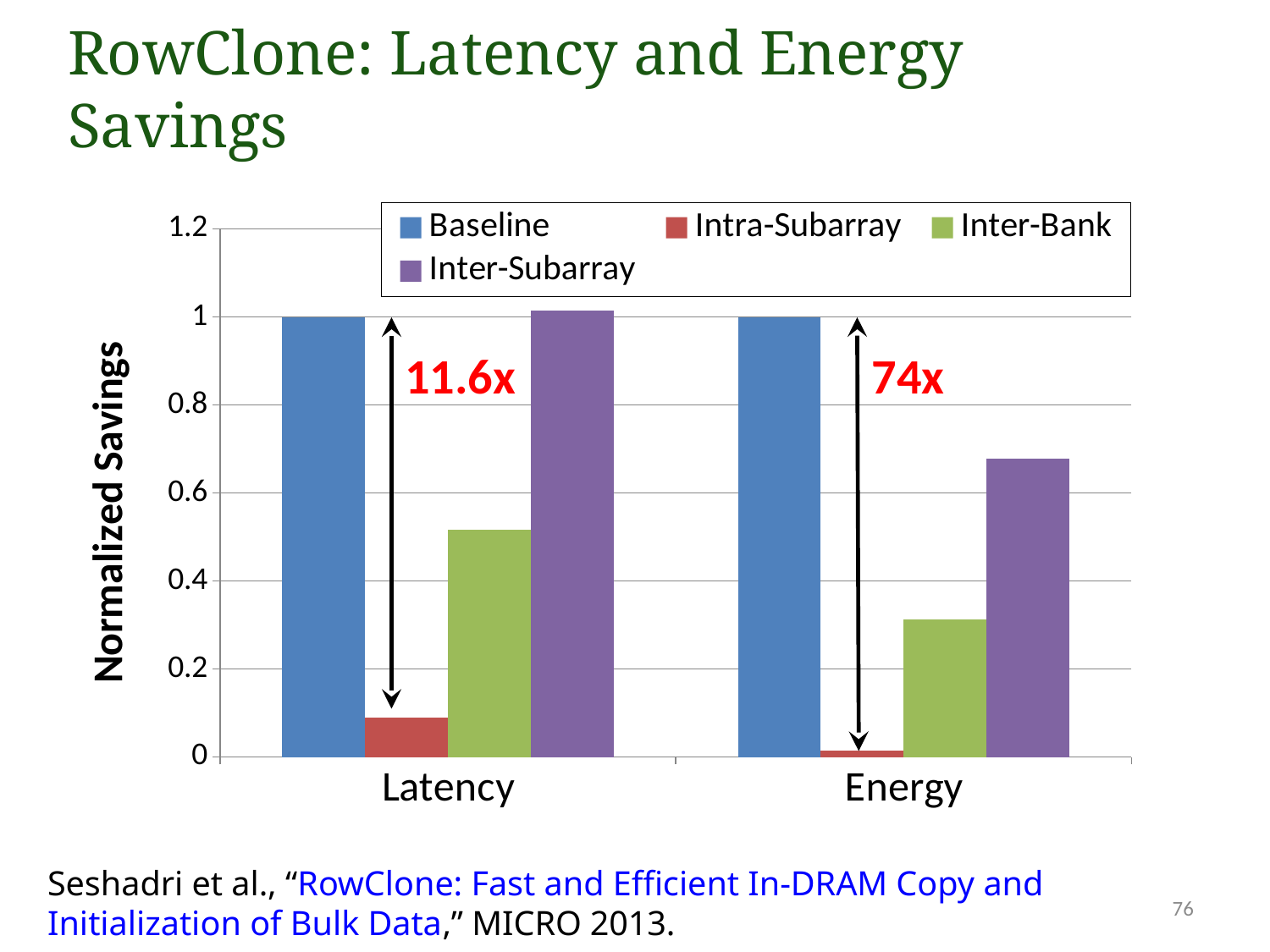
What improvement factor is annotated on the Energy group of bars? 74x What kind of chart is shown on the slide? bar chart What is the Baseline value for Latency? 1 Is the Inter-Bank value for Latency greater or less than 0.4? greater Is the Intra-Subarray value for Latency greater or less than 0.2? less Which series has the lowest value for Energy? Intra-Subarray How many categories are shown on the x axis? 2 What is the Baseline value for Energy? 1 Is the Inter-Bank value for Energy greater or less than 0.4? less How many series does the legend list? 4 For Latency, which is larger: the Inter-Bank value or the Inter-Subarray value? Inter-Subarray